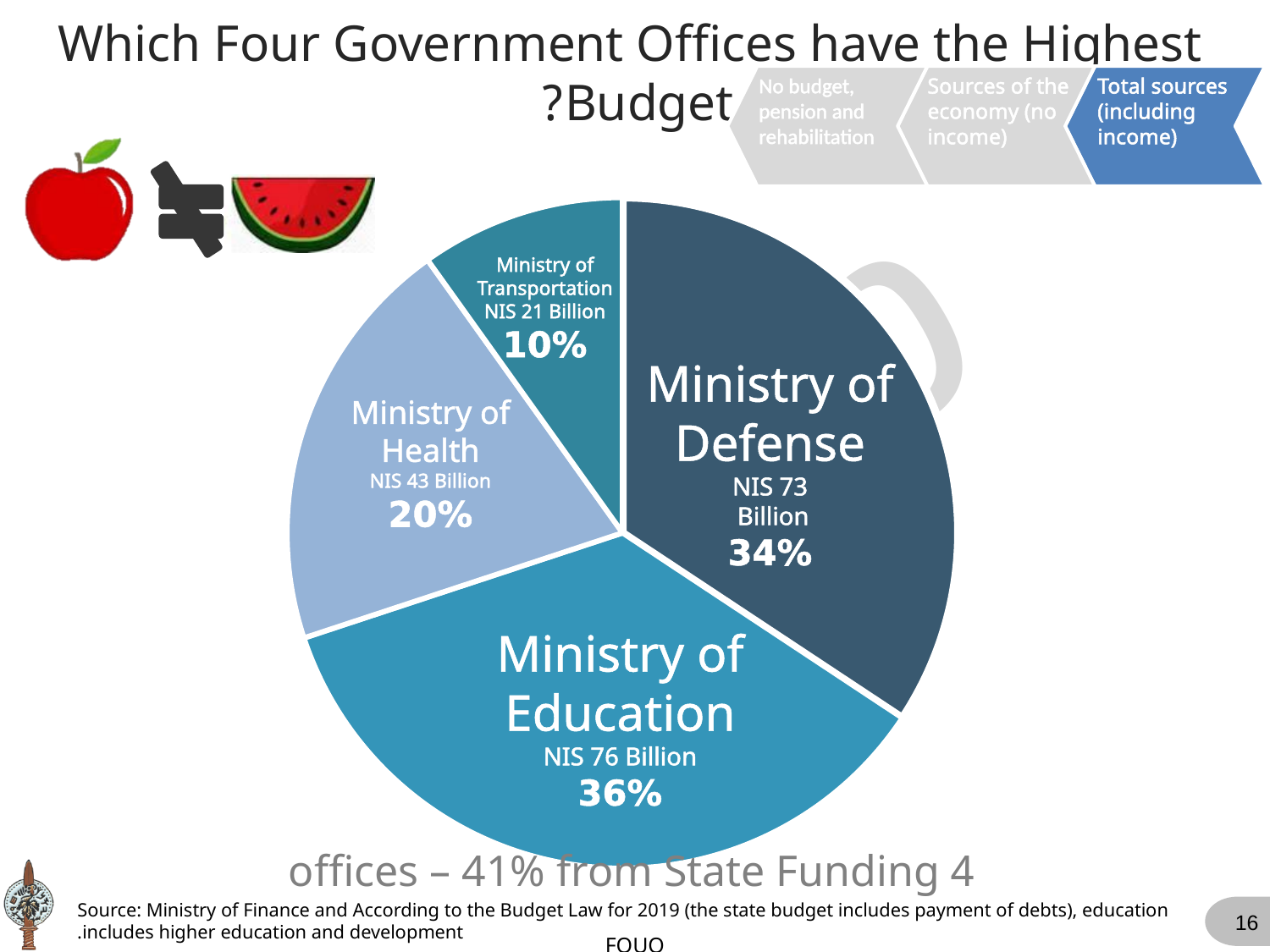
What share of the pie does the Ministry of Transportation represent? 10% What is the budget of the Ministry of Defense? NIS 73 Billion What is the budget of the Ministry of Education? NIS 76 Billion What is the difference in budget between the Ministry of Health and the Ministry of Transportation? NIS 22 Billion Which has a larger budget, the Ministry of Defense or the Ministry of Health? Ministry of Defense What share of the pie does the Ministry of Health represent? 20% How many slices does the pie chart have? 4 What is the budget of the Ministry of Transportation? NIS 21 Billion What kind of chart is shown on the slide? Pie chart Which ministry has the smallest budget in the pie chart? Ministry of Transportation Which ministry has the largest budget in the pie chart? Ministry of Education What is the budget of the Ministry of Health? NIS 43 Billion